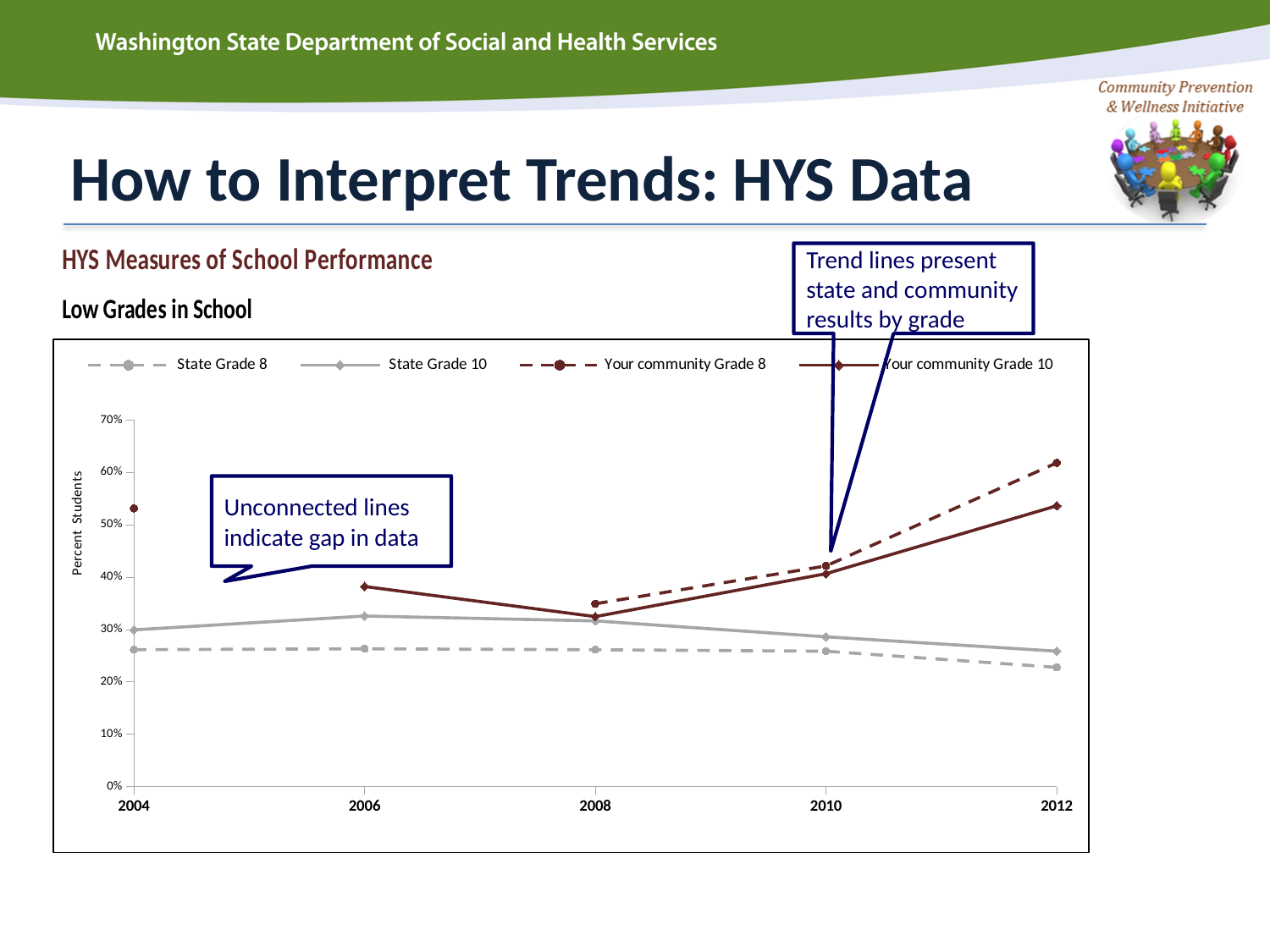
Is the value for State Grade 8 in 2012 greater or less than 30%? less What kind of chart is shown on the slide? line chart Is the value for Your community Grade 8 in 2012 greater or less than 50%? greater In 2010, which is larger: Your community Grade 10 or State Grade 10? Your community Grade 10 Does the State Grade 10 line rise or fall from 2006 to 2012? fall How many series does the legend list? 4 Which series has the lowest value in 2012? State Grade 8 Is the value for Your community Grade 8 in 2004 greater or less than 50%? greater Does the Your community Grade 8 line rise or fall from 2008 to 2012? rise Which series has the highest value in 2012? Your community Grade 8 In 2012, which is larger: Your community Grade 8 or Your community Grade 10? Your community Grade 8 How many years are shown on the x axis? 5